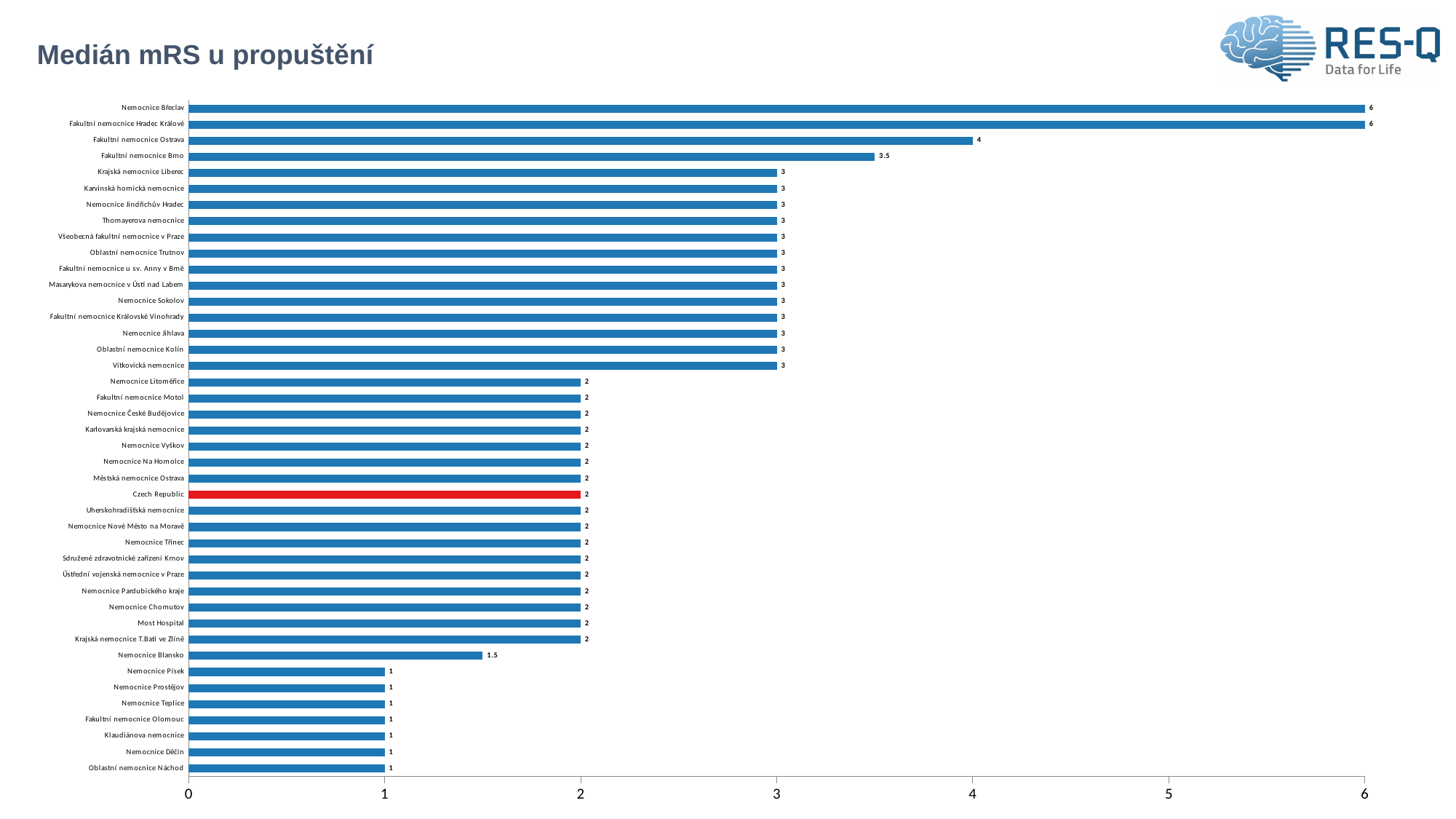
What is the value shown for Fakultní nemocnice Brno? 3.5 Which has a larger value, Fakultní nemocnice Brno or Krajská nemocnice Liberec? Fakultní nemocnice Brno What is the median mRS at discharge for Fakultní nemocnice Ostrava? 4 What is the value shown for Nemocnice Blansko? 1.5 What is the value shown for Nemocnice Břeclav? 6 What is the difference between the values for Fakultní nemocnice Ostrava and Nemocnice Blansko? 2.5 What kind of chart is shown on the slide? Bar chart Which category's bar is coloured red instead of blue? Czech Republic Which has a larger value, Nemocnice Písek or Nemocnice Blansko? Nemocnice Blansko What is the value shown for Czech Republic? 2 How many hospitals/categories are plotted on the chart? 42 What is the title of the chart on the slide? Medián mRS u propuštění